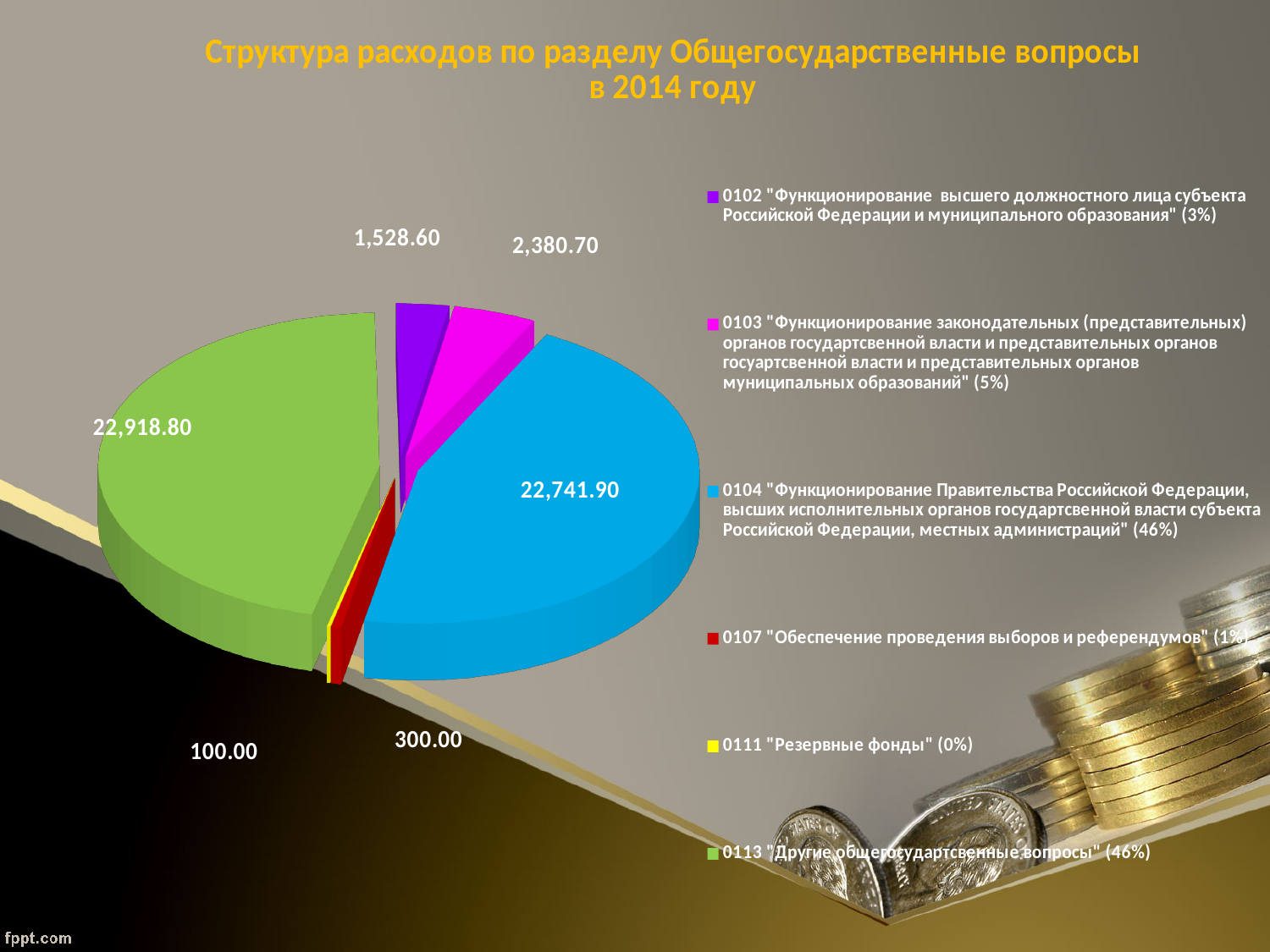
Which category has the largest value in the pie chart? 0113 "Другие общегосударственные вопросы" What is the value for 0107 "Обеспечение проведения выборов и референдумов"? 300.00 How many slices does the pie chart have? 6 What is the value for 0111 "Резервные фонды"? 100.00 What is the value for 0113 "Другие общегосударственные вопросы"? 22,918.80 What is the value for 0104 "Функционирование Правительства Российской Федерации..."? 22,741.90 What share of the pie does 0104 "Функционирование Правительства Российской Федерации..." represent? 46% How many entries does the legend list? 6 What type of chart is shown on the slide? pie chart Which category has the smallest value in the pie chart? 0111 "Резервные фонды" What is the difference between the values for 0103 (2,380.70) and 0102 (1,528.60)? 852.10 Which colour represents 0102 "Функционирование высшего должностного лица..." in the pie chart? purple